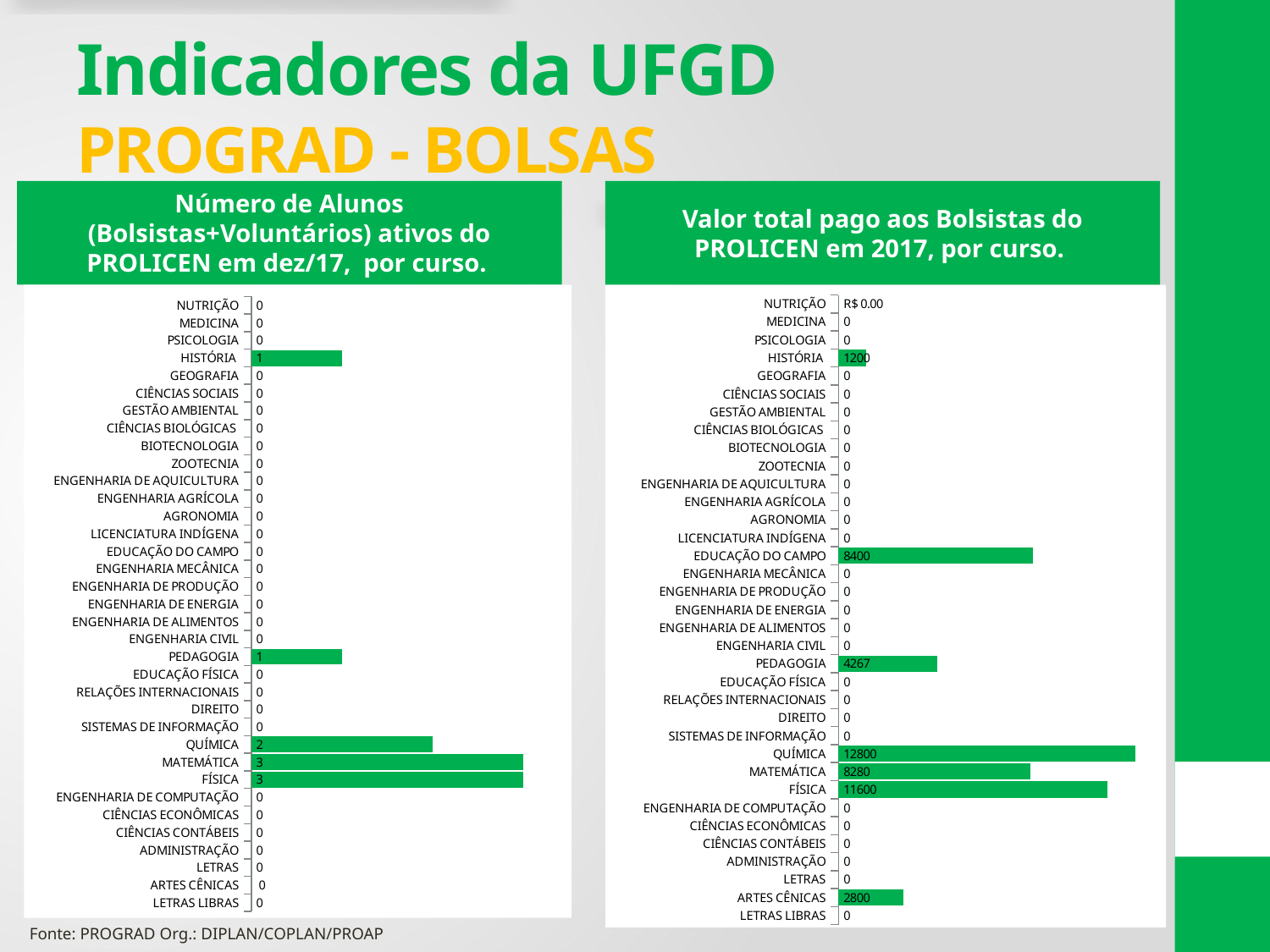
In the chart 'Valor total pago aos Bolsistas do PROLICEN em 2017, por curso', which is larger, the value for EDUCAÇÃO DO CAMPO or the value for FÍSICA? FÍSICA In the chart 'Valor total pago aos Bolsistas do PROLICEN em 2017, por curso', what is the value for QUÍMICA? 12800 In the chart 'Número de Alunos (Bolsistas+Voluntários) ativos do PROLICEN em dez/17, por curso', what is the value for QUÍMICA? 2 In the chart 'Valor total pago aos Bolsistas do PROLICEN em 2017, por curso', which course has the highest value? QUÍMICA In the chart 'Valor total pago aos Bolsistas do PROLICEN em 2017, por curso', what is the value for PEDAGOGIA? 4267 In the chart 'Número de Alunos (Bolsistas+Voluntários) ativos do PROLICEN em dez/17, por curso', what is the value for PEDAGOGIA? 1 In the chart 'Valor total pago aos Bolsistas do PROLICEN em 2017, por curso', what is the value for ARTES CÊNICAS? 2800 In the chart 'Número de Alunos (Bolsistas+Voluntários) ativos do PROLICEN em dez/17, por curso', what is the value for FÍSICA? 3 What kind of chart is the chart 'Valor total pago aos Bolsistas do PROLICEN em 2017, por curso'? Bar chart In the chart 'Número de Alunos (Bolsistas+Voluntários) ativos do PROLICEN em dez/17, por curso', what is the difference between the values for MATEMÁTICA and QUÍMICA? 1 In the chart 'Valor total pago aos Bolsistas do PROLICEN em 2017, por curso', what is the difference between the values for QUÍMICA and FÍSICA? 1200 In the chart 'Número de Alunos (Bolsistas+Voluntários) ativos do PROLICEN em dez/17, por curso', which is larger, the value for HISTÓRIA or the value for QUÍMICA? QUÍMICA